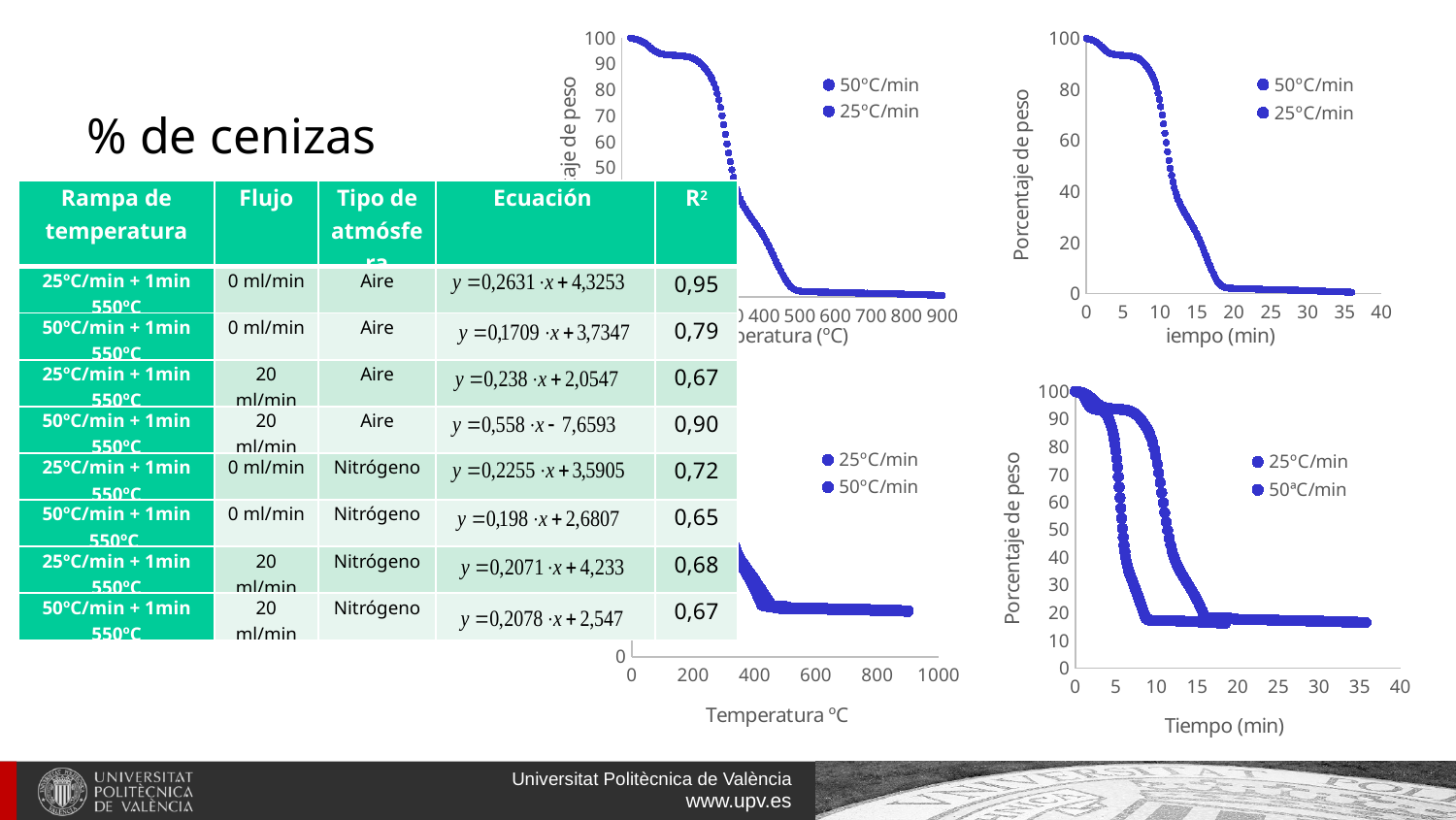
What are the two legend entries of the top-right chart? 50°C/min and 25°C/min How many series does the legend of the bottom-right chart list? 2 In the bottom-middle chart (x axis Temperatura ºC), is the value at 800 greater or less than 40? less In the bottom-right chart, is the value at 35 min greater or less than 10? greater In the bottom-middle chart, do the values rise or fall as temperature increases? fall What is the x-axis title of the bottom-right chart? Tiempo (min) How many charts are shown on the slide? 4 What kind of chart is the bottom-right chart on the slide? scatter chart In the top-right chart, is the value at 5 min greater or less than 80? greater In the top-right chart, do the values rise or fall as time increases? fall How many series does the legend of the bottom-middle chart list? 2